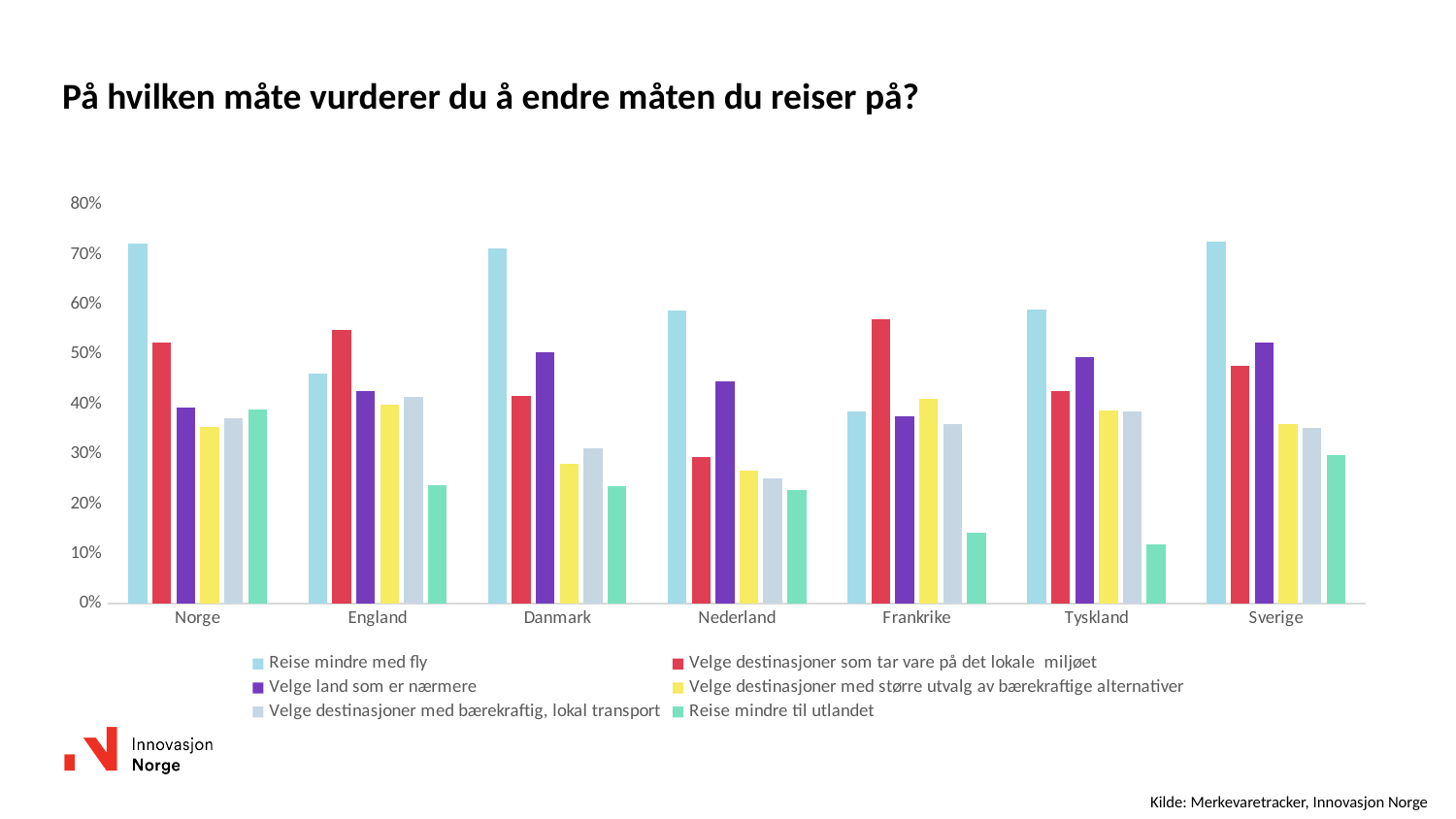
In Frankrike, which is larger: 'Reise mindre med fly' or 'Velge destinasjoner som tar vare på det lokale miljøet'? Velge destinasjoner som tar vare på det lokale miljøet Is the value for 'Reise mindre til utlandet' in Nederland greater or less than 30%? less In Nederland, which is larger: 'Velge land som er nærmere' or 'Velge destinasjoner som tar vare på det lokale miljøet'? Velge land som er nærmere Is the value for 'Reise mindre med fly' in Norge greater or less than 60%? greater Which country has the lowest value for 'Reise mindre med fly'? Frankrike Which country has the highest value for 'Reise mindre til utlandet'? Norge What kind of chart is shown on the slide? Bar chart How many countries are shown on the x axis of the chart? 7 Is the value for 'Reise mindre til utlandet' in Frankrike greater or less than 20%? less How many series does the legend list? 6 What is the title of the chart? På hvilken måte vurderer du å endre måten du reiser på?